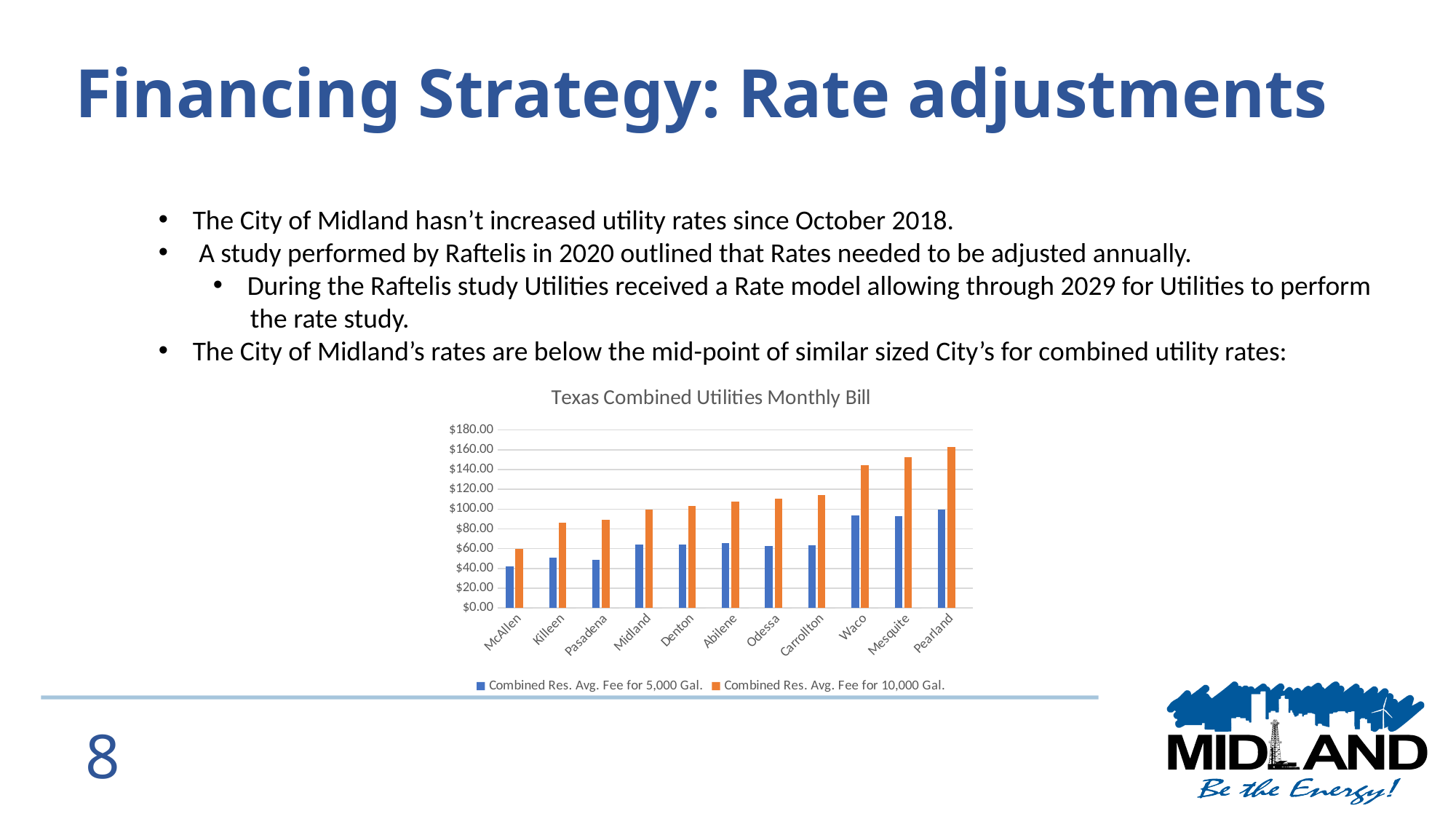
Which city has the larger Combined Res. Avg. Fee for 10,000 Gal., Waco or Midland? Waco What is the title of the chart? Texas Combined Utilities Monthly Bill Is the Combined Res. Avg. Fee for 10,000 Gal. for McAllen greater or less than $80.00? less Which city has the highest Combined Res. Avg. Fee for 10,000 Gal.? Pearland Do the Combined Res. Avg. Fee for 10,000 Gal. values rise or fall from McAllen to Pearland along the x axis? rise How many series does the chart's legend list? 2 Is the Combined Res. Avg. Fee for 5,000 Gal. for Waco greater or less than $80.00? greater Which city has the lowest Combined Res. Avg. Fee for 10,000 Gal.? McAllen How many cities are shown on the x axis of the chart? 11 Is the Combined Res. Avg. Fee for 10,000 Gal. for Midland greater or less than $120.00? less What kind of chart is shown on the slide? bar chart